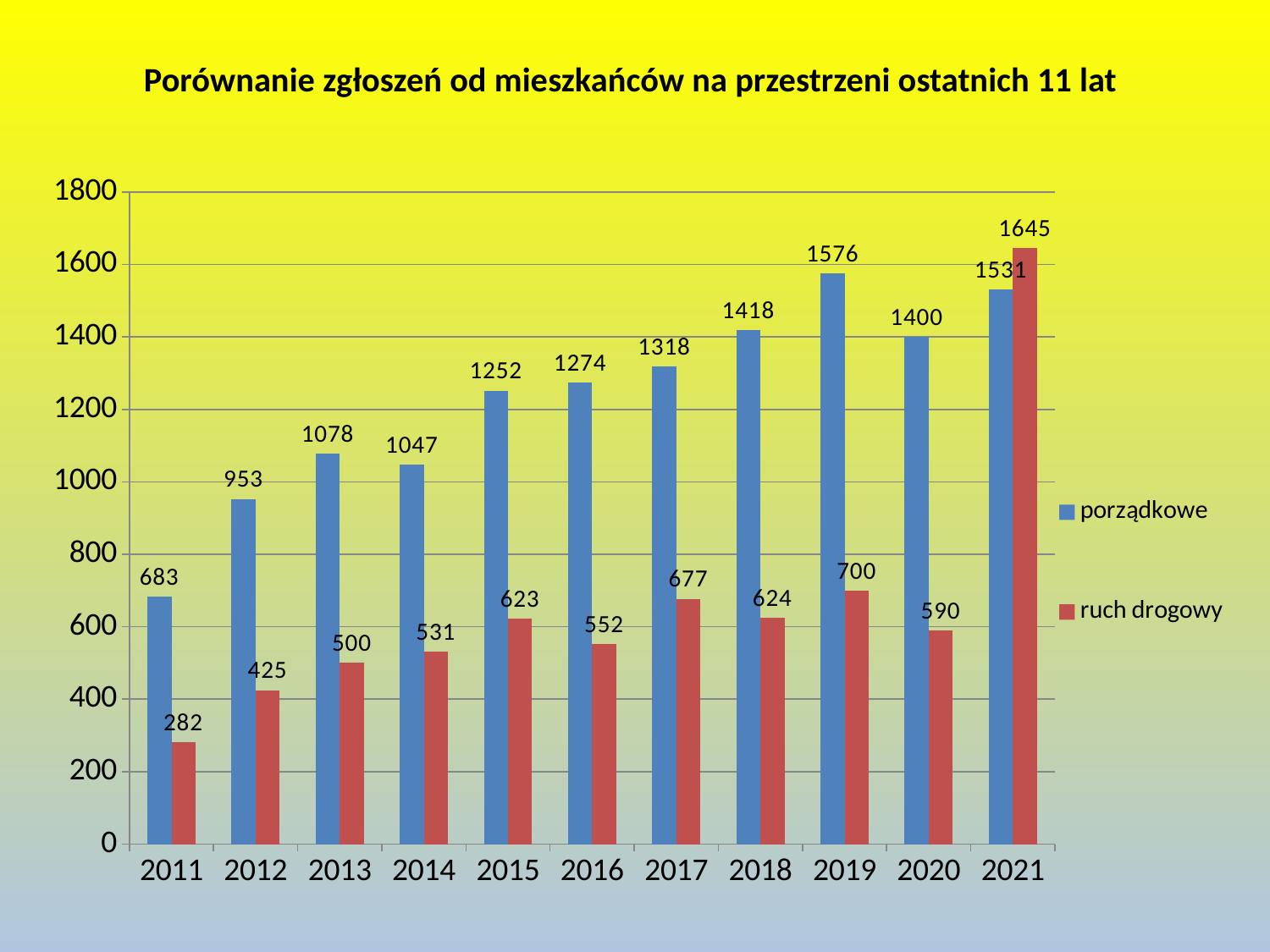
What is the value for ruch drogowy in 2019? 700 What colour are the bars for ruch drogowy? red Which year has the lowest value for ruch drogowy? 2011 What kind of chart is shown on the slide? bar chart Does the value for ruch drogowy rise or fall from 2011 to 2013? rise Which year has the highest value for porządkowe? 2019 How many series does the legend list? 2 How many years are shown on the x axis? 11 What is the difference between porządkowe and ruch drogowy in 2011? 401 What is the value for porządkowe in 2015? 1252 Is the value for ruch drogowy in 2017 greater or less than 600? greater Which is larger in 2021, porządkowe or ruch drogowy? ruch drogowy